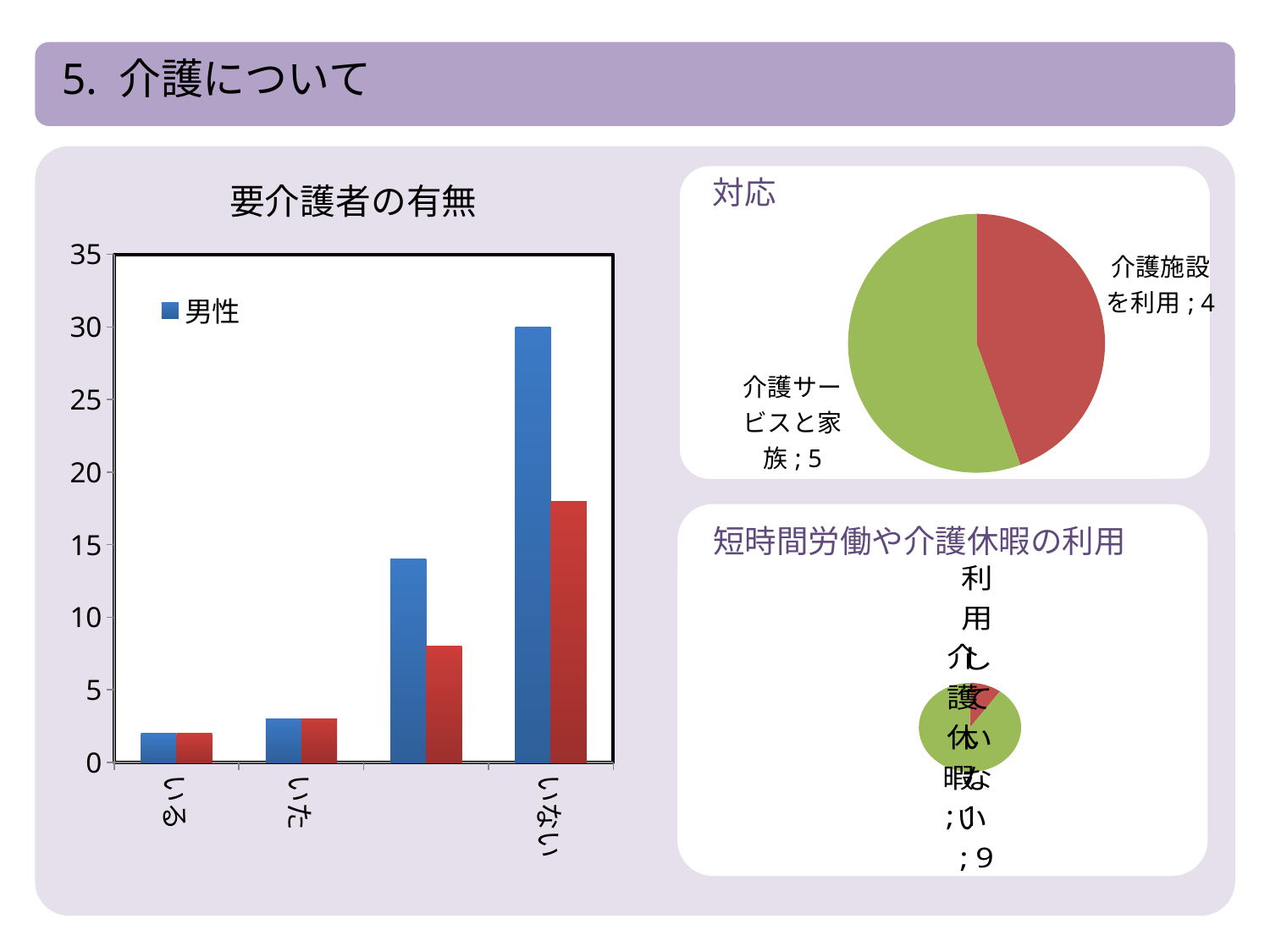
In the 要介護者の有無 chart, is the 男性 value for いる greater or less than 5? less In the 要介護者の有無 chart, is the 男性 value for いない greater or less than 25? greater What kind of chart is the 要介護者の有無 chart? bar chart In the 対応 pie chart, which slice is larger, 介護施設を利用 or 介護サービスと家族? 介護サービスと家族 In the 対応 pie chart, what is the value for 介護施設を利用? 4 In the 要介護者の有無 chart, do the 男性 values rise or fall from いる to いない along the x axis? rise In the 要介護者の有無 chart, what is the 男性 value for いない? 30 In the 要介護者の有無 chart, which series name is shown in the legend? 男性 In the 対応 pie chart, what is the value for 介護サービスと家族? 5 In the 要介護者の有無 chart, which category has the highest 男性 value? いない In the 対応 pie chart, what is the difference between 介護サービスと家族 and 介護施設を利用? 1 In the 要介護者の有無 chart, is the red-series value for いない greater or less than 15? greater